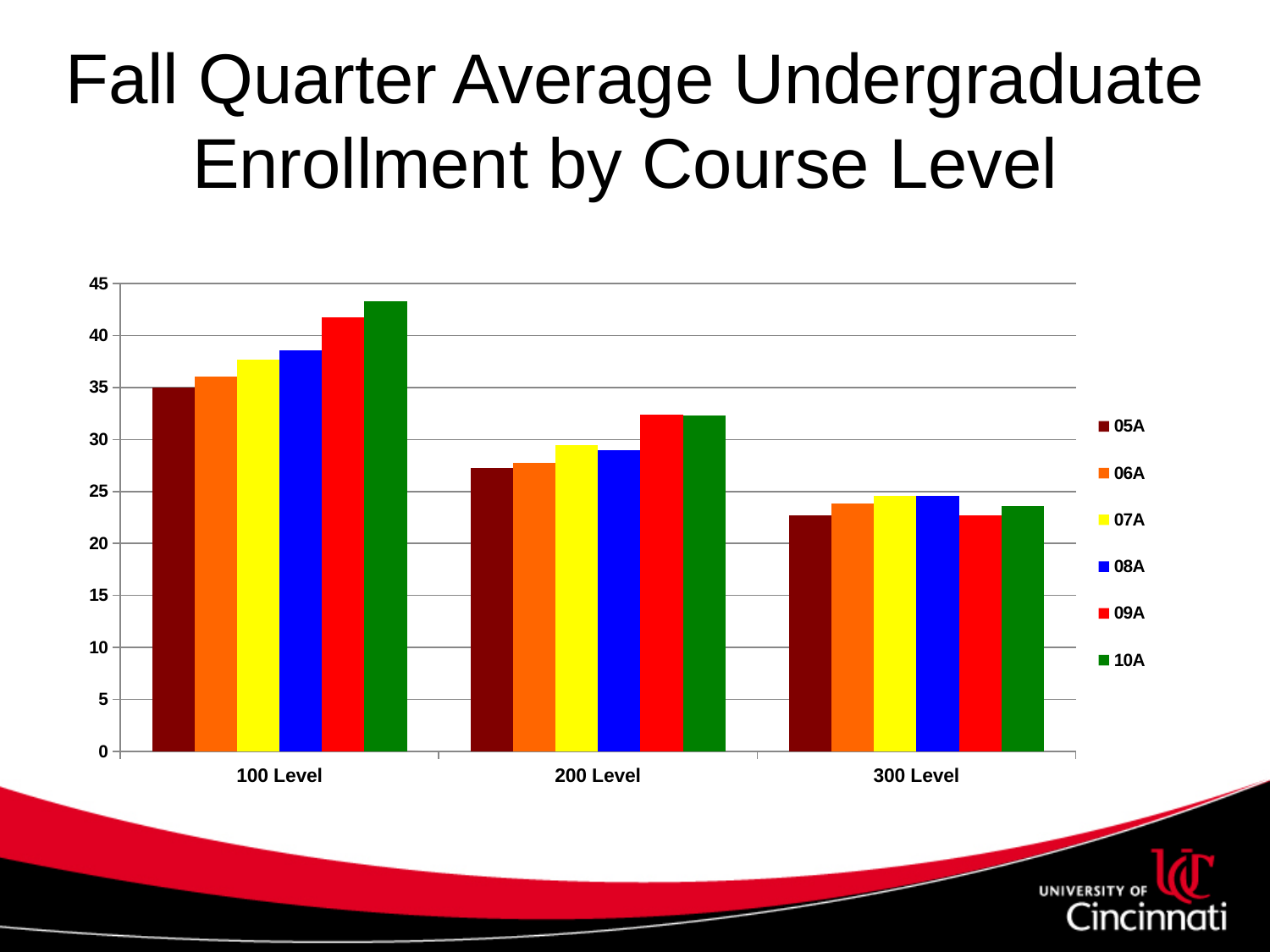
At 300 Level, which is larger: the value for 07A or the value for 05A? 07A What kind of chart is shown on the slide? bar chart Is the value for 10A at 100 Level greater or less than 40? greater Is the value for 09A at 200 Level greater or less than 30? greater Do the values for the 10A series rise or fall from 100 Level to 300 Level? fall Is the value for 05A at 200 Level greater or less than 30? less Within the 100 Level group, which series has the lowest bar? 05A What colour are the bars for the 10A series? green How many series does the legend list? 6 Within the 100 Level group, which series has the highest bar? 10A How many course level categories are shown on the x axis? 3